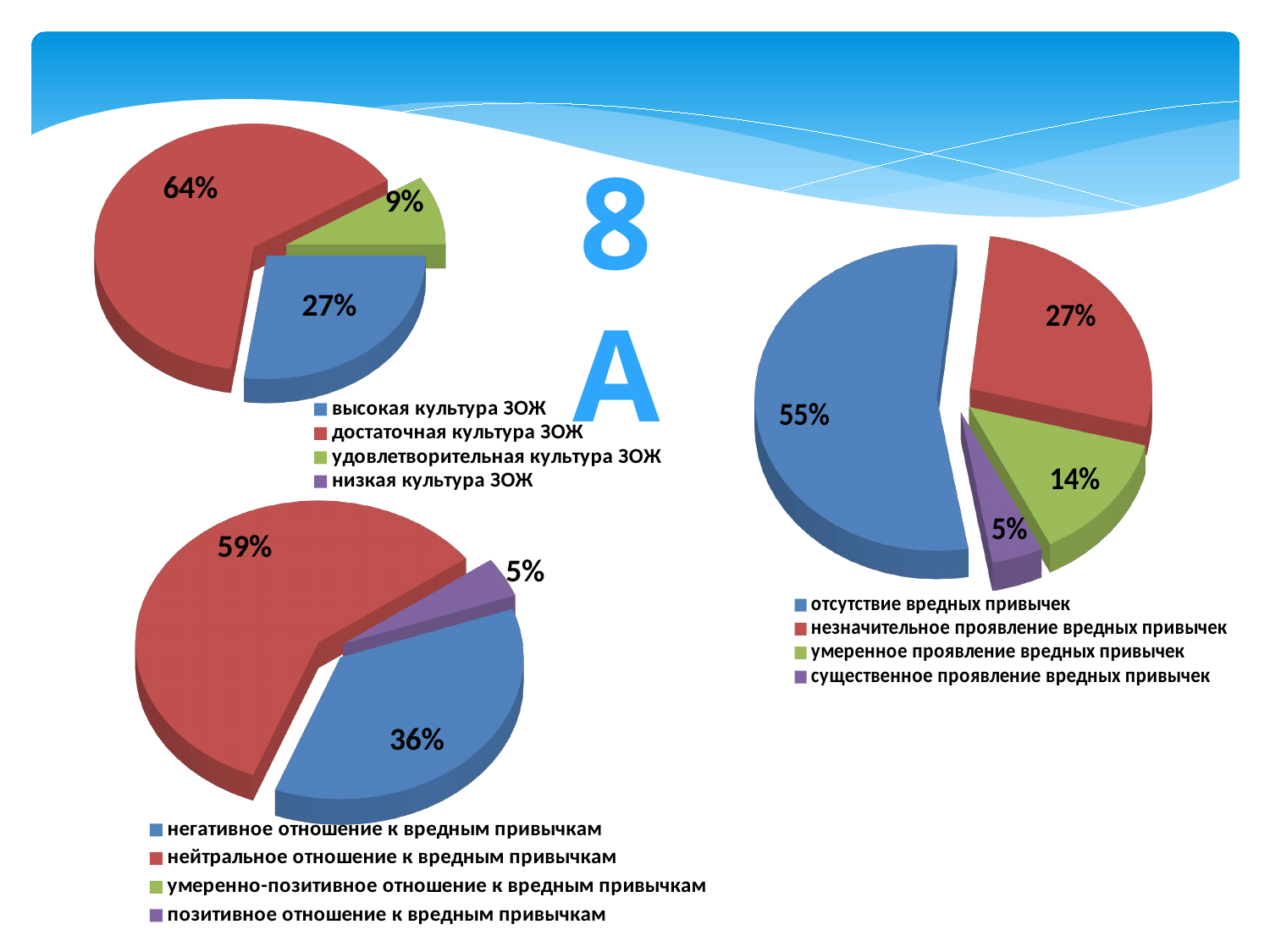
In the top-left pie chart, what share is labelled for 'достаточная культура ЗОЖ'? 64% What type of chart is the bottom-left chart? pie chart How many entries does the legend of the right-hand pie chart list? 4 In the bottom-left pie chart, what share is labelled for 'позитивное отношение к вредным привычкам'? 5% In the right-hand pie chart, what share is labelled for 'умеренное проявление вредных привычек'? 14% In the top-left pie chart, what share is labelled for 'высокая культура ЗОЖ'? 27% In the bottom-left pie chart, which is larger: 'негативное отношение к вредным привычкам' or 'нейтральное отношение к вредным привычкам'? нейтральное отношение к вредным привычкам In the top-left pie chart, which category has the smallest labelled slice? удовлетворительная культура ЗОЖ In the top-left pie chart, what is the difference between the 'достаточная культура ЗОЖ' and 'высокая культура ЗОЖ' shares? 37% In the right-hand pie chart, what share is labelled for 'отсутствие вредных привычек'? 55% In the bottom-left pie chart, what share is labelled for 'нейтральное отношение к вредным привычкам'? 59% In the right-hand pie chart, which category has the largest slice? отсутствие вредных привычек